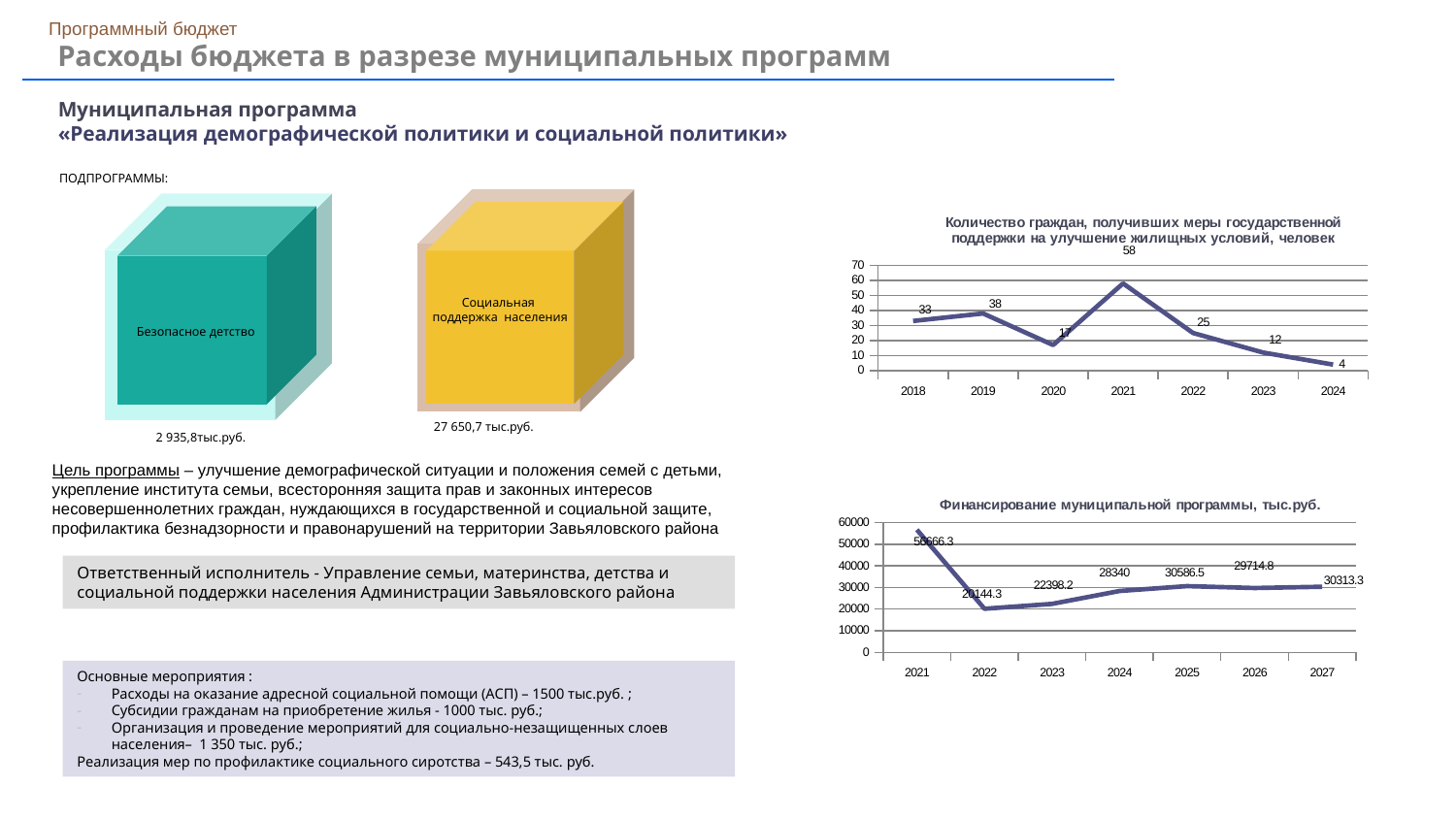
In the chart 'Финансирование муниципальной программы, тыс.руб.', is the value for 2021 greater or less than 50000? greater In the chart 'Финансирование муниципальной программы, тыс.руб.', what is the value for 2027? 30313.3 In the chart 'Количество граждан, получивших меры государственной поддержки на улучшение жилищных условий, человек', what is the value for 2021? 58 In the chart 'Финансирование муниципальной программы, тыс.руб.', which year has the lowest value? 2022 In the chart 'Количество граждан, получивших меры государственной поддержки на улучшение жилищных условий, человек', what is the difference between the values for 2019 and 2020? 21 In the chart 'Количество граждан, получивших меры государственной поддержки на улучшение жилищных условий, человек', how many years are plotted? 7 In the chart 'Финансирование муниципальной программы, тыс.руб.', what is the value for 2024? 28340 In the chart 'Количество граждан, получивших меры государственной поддержки на улучшение жилищных условий, человек', which year has the highest value? 2021 In the chart 'Количество граждан, получивших меры государственной поддержки на улучшение жилищных условий, человек', what is the value for 2024? 4 In the chart 'Количество граждан, получивших меры государственной поддержки на улучшение жилищных условий, человек', which year has the lowest value? 2024 What type of chart is 'Финансирование муниципальной программы, тыс.руб.'? line chart In the chart 'Финансирование муниципальной программы, тыс.руб.', which is larger, the value for 2025 or the value for 2026? 2025